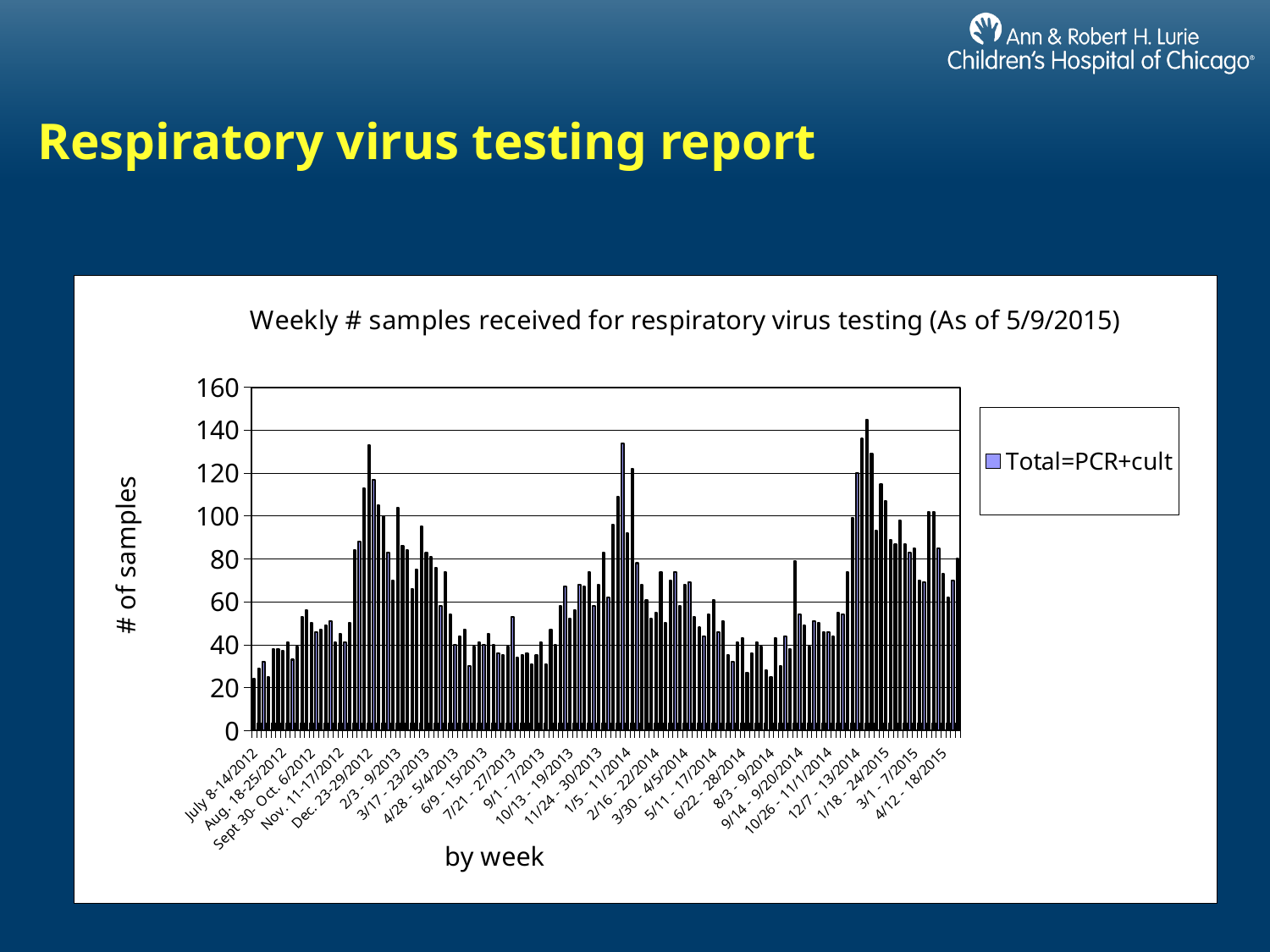
Is the highest bar on the chart greater or less than 140? greater Is the value for the week 2/3 - 9/2013 greater or less than 60? greater What kind of chart is shown on the slide? bar chart What is the title of the chart? Weekly # samples received for respiratory virus testing (As of 5/9/2015) Is the value for the first week, July 8-14/2012, greater or less than 40? less What is the maximum value shown on the y axis? 160 What is the legend entry for the plotted series? Total=PCR+cult How many series does the legend list? 1